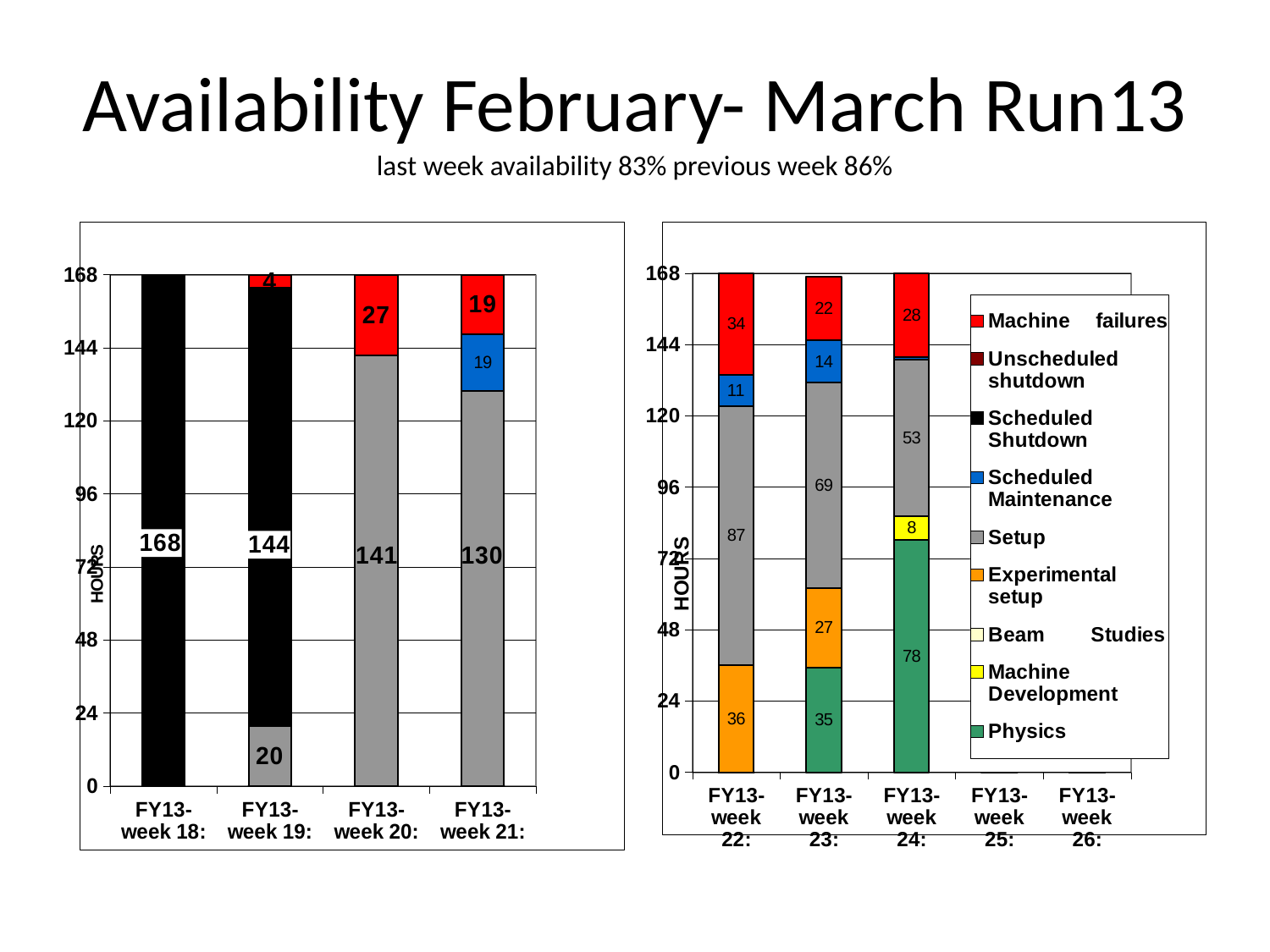
In the right chart, how many series does the legend list? 9 What kind of chart is the left chart? Stacked bar chart In the right chart, what is the total of the stacked bar for FY13-week 23? 167 In the right chart, what is the Physics value for FY13-week 24? 78 In the left chart, what is the value of the black segment for FY13-week 19? 144 In the left chart, what is the value of the red segment for FY13-week 20? 27 In the right chart, what is the difference between the Setup values for FY13-week 22 and FY13-week 24? 34 In the right chart, which week has the larger Machine failures value, FY13-week 22 or FY13-week 24? FY13-week 22 In the right chart, which week has the highest Physics value? FY13-week 24 In the right chart, what is the Machine failures value for FY13-week 23? 22 In the right chart, what is the Setup value for FY13-week 22? 87 In the left chart, how many weeks are shown on the x axis? 4